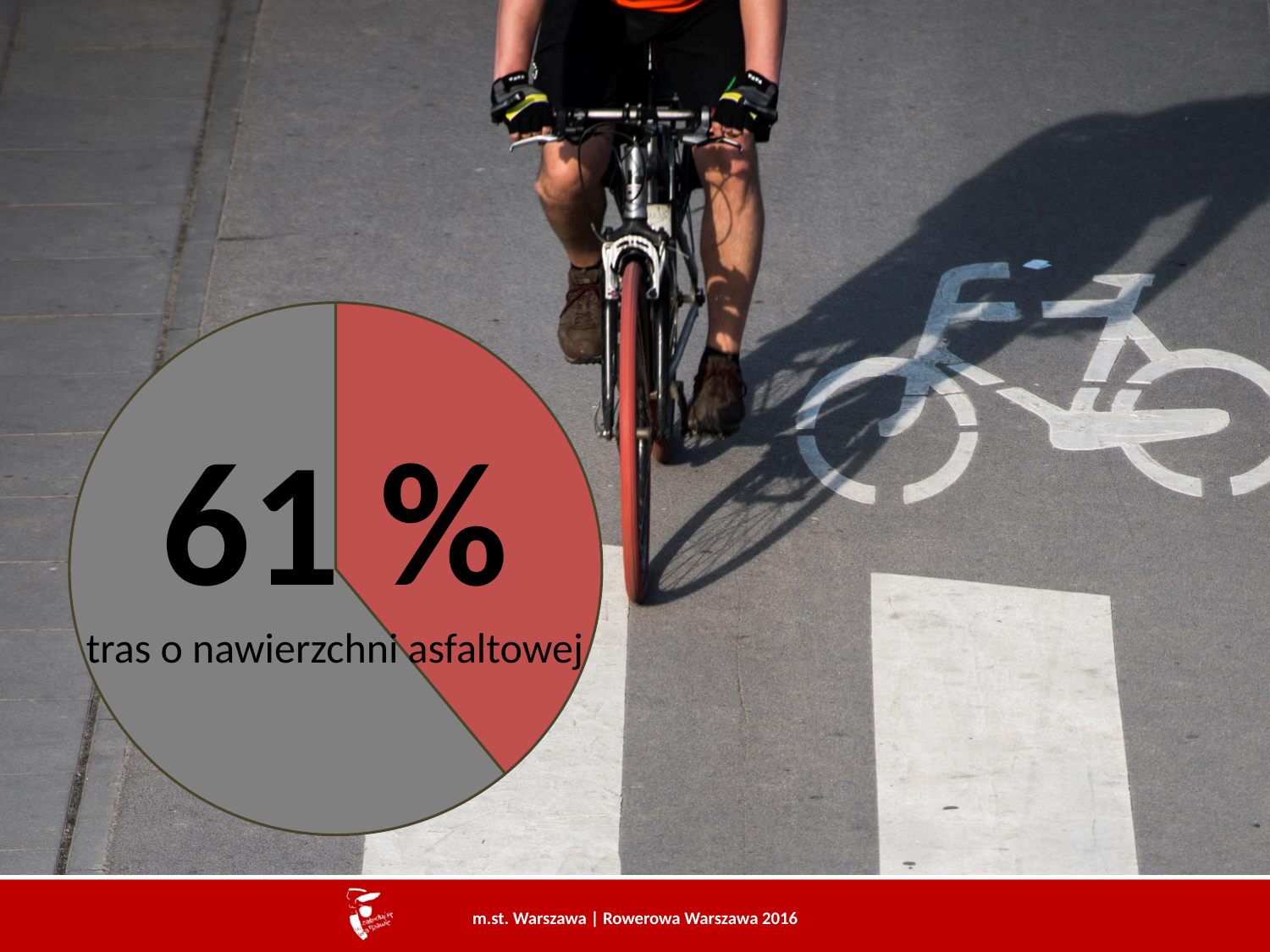
What percentage is printed on the pie chart? 61 % What two colours are used for the slices of the pie chart? grey and red Which slice of the pie chart is larger, the grey one or the red one? grey How many slices does the pie chart have? 2 What share of routes have an asphalt surface according to the slide? 61 % Is the grey slice of the pie chart greater or less than half of the pie? greater What text appears below the percentage on the pie chart? tras o nawierzchni asfaltowej Is the red slice of the pie chart greater or less than half of the pie? less What kind of chart is shown on the slide? pie chart